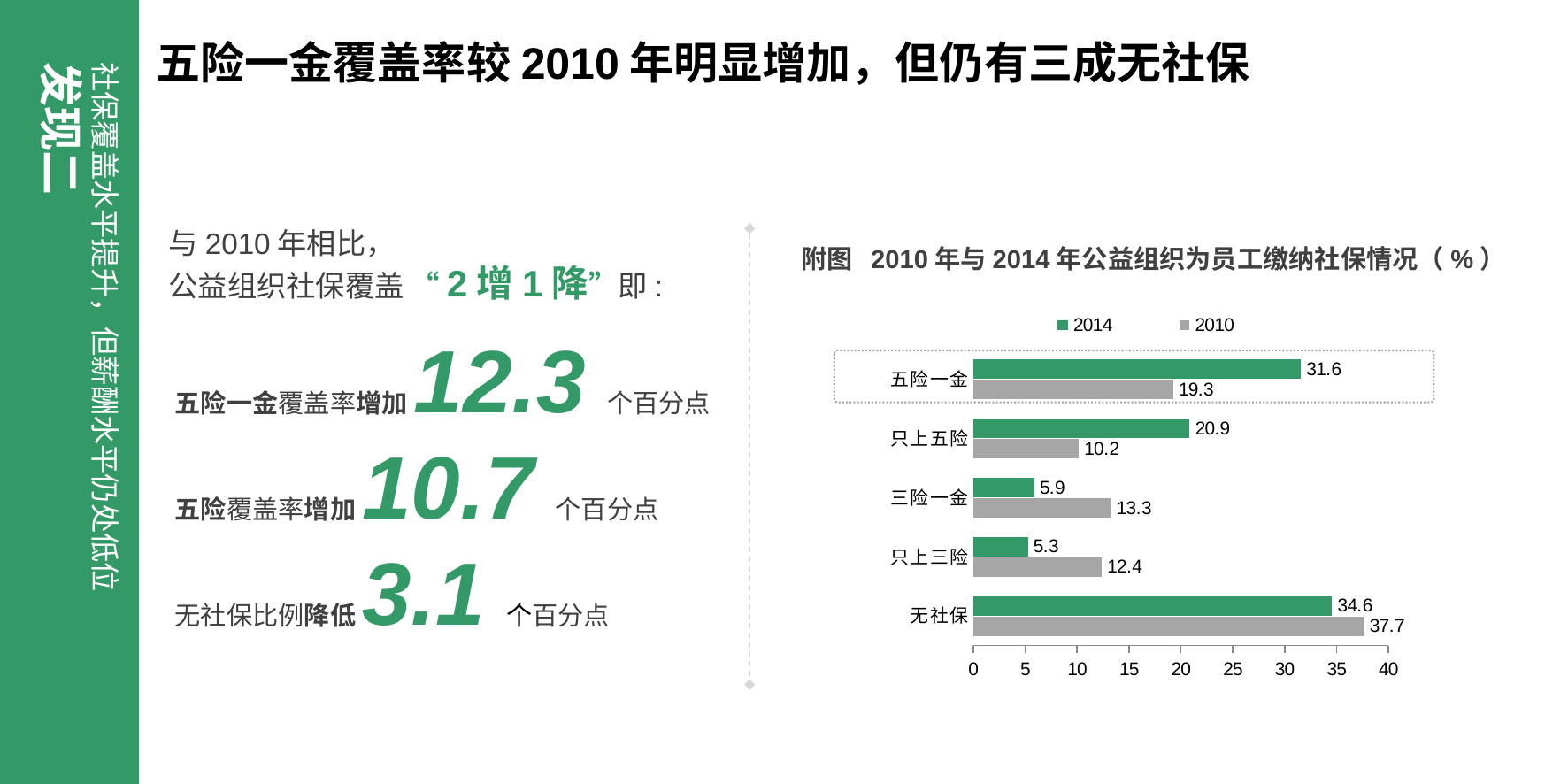
Which category has the lowest 2010 value? 只上五险 What is the 2014 value for 五险一金? 31.6 How many series does the legend list? 2 Which category has the lowest 2014 value? 只上三险 What is the difference between the 2014 and 2010 values for 五险一金? 12.3 What kind of chart is shown on the slide? Bar chart What is the difference between the 2014 and 2010 values for 只上五险? 10.7 Which category has the highest 2014 value? 无社保 What is the 2010 value for 无社保? 37.7 For 三险一金, which year has the larger value, 2014 or 2010? 2010 What is the 2010 value for 只上三险? 12.4 How many categories are shown on the chart? 5